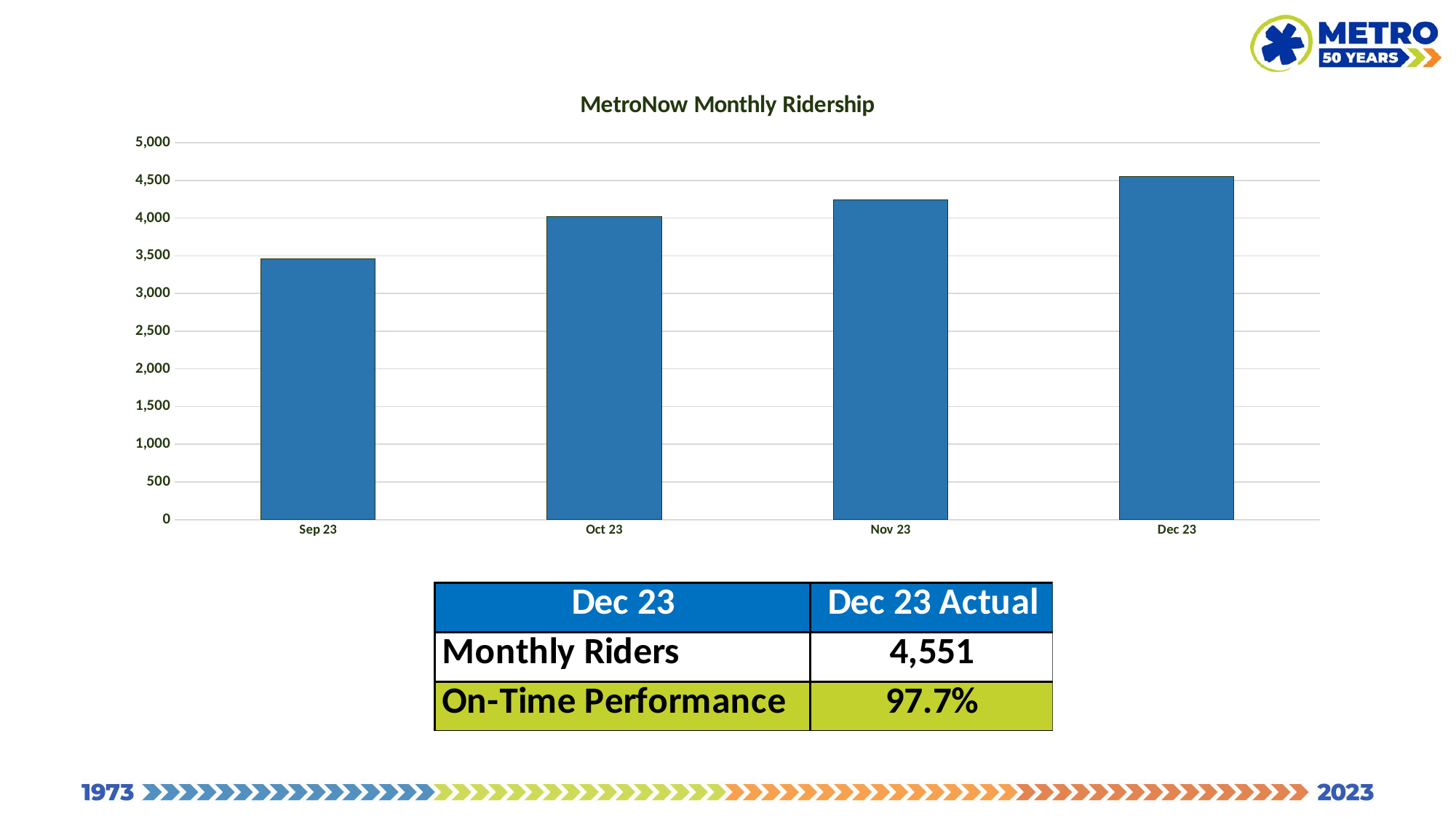
Is the value for Sep 23 greater or less than 3,000? greater What is the title of the chart? MetroNow Monthly Ridership Which month has the lowest ridership in the chart? Sep 23 What is the monthly ridership for Dec 23? 4,551 What kind of chart is shown on the slide? bar chart How many months are plotted in the MetroNow Monthly Ridership chart? 4 Which month has higher ridership, Sep 23 or Dec 23? Dec 23 Do the ridership values rise or fall from Sep 23 to Dec 23? rise Which month has the highest ridership in the chart? Dec 23 Is the value for Oct 23 greater or less than 4,500? less Is the value for Nov 23 greater or less than 4,000? greater Which month has higher ridership, Oct 23 or Nov 23? Nov 23